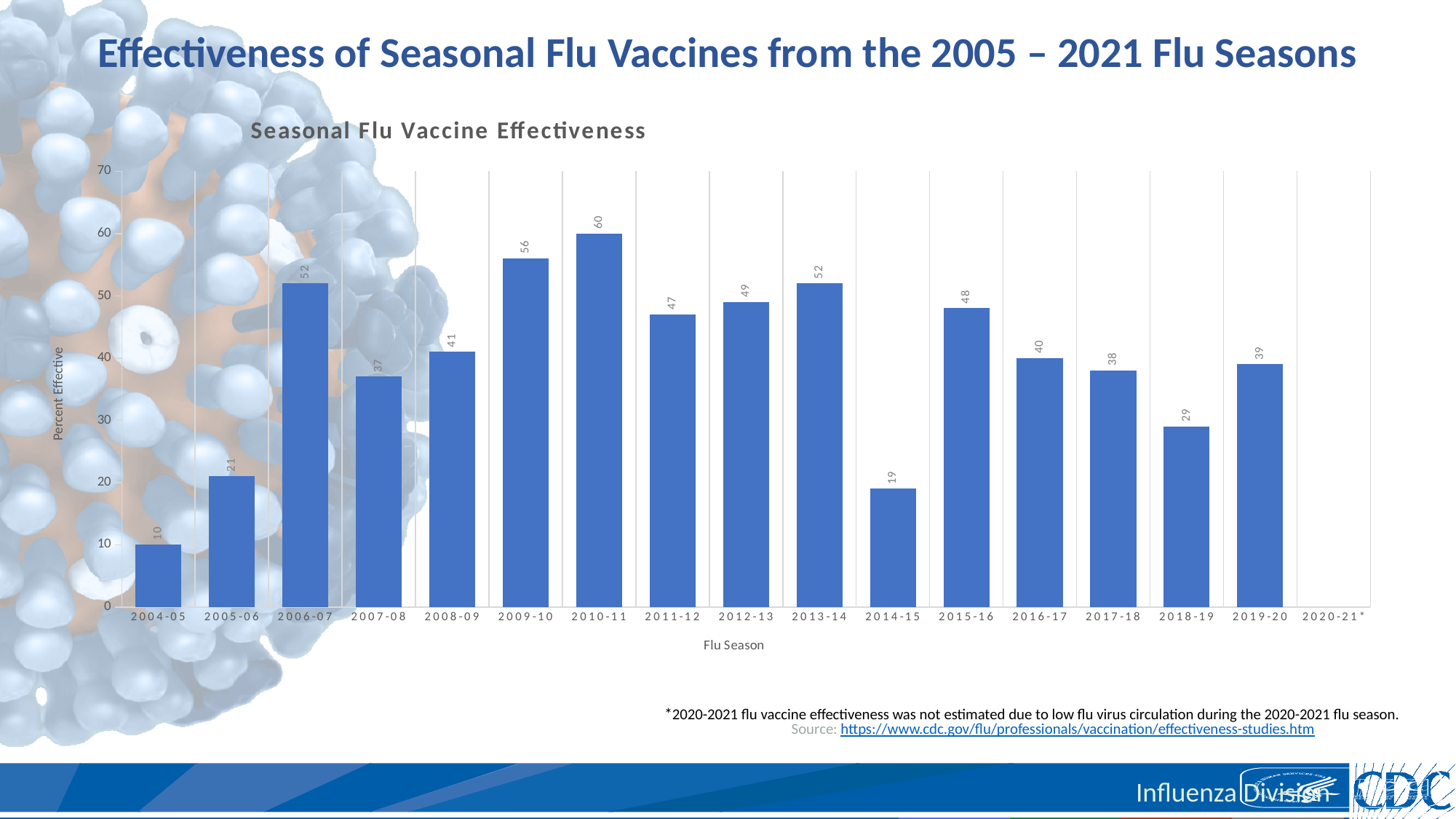
Which flu season has the highest vaccine effectiveness? 2010-11 What is the difference in vaccine effectiveness between the 2010-11 and 2014-15 seasons? 41 How many flu seasons are labeled on the x axis? 17 What is the vaccine effectiveness value for the 2014-15 flu season? 19 What is the vaccine effectiveness value for the 2010-11 flu season? 60 What is the title of the chart? Seasonal Flu Vaccine Effectiveness Is the value for 2006-07 greater or less than 50? greater What is the vaccine effectiveness value for the 2019-20 flu season? 39 What kind of chart is shown on the slide? Bar chart Which season has a higher vaccine effectiveness, 2009-10 or 2013-14? 2009-10 What is the label of the y axis? Percent Effective Which flu season has the lowest plotted vaccine effectiveness? 2004-05